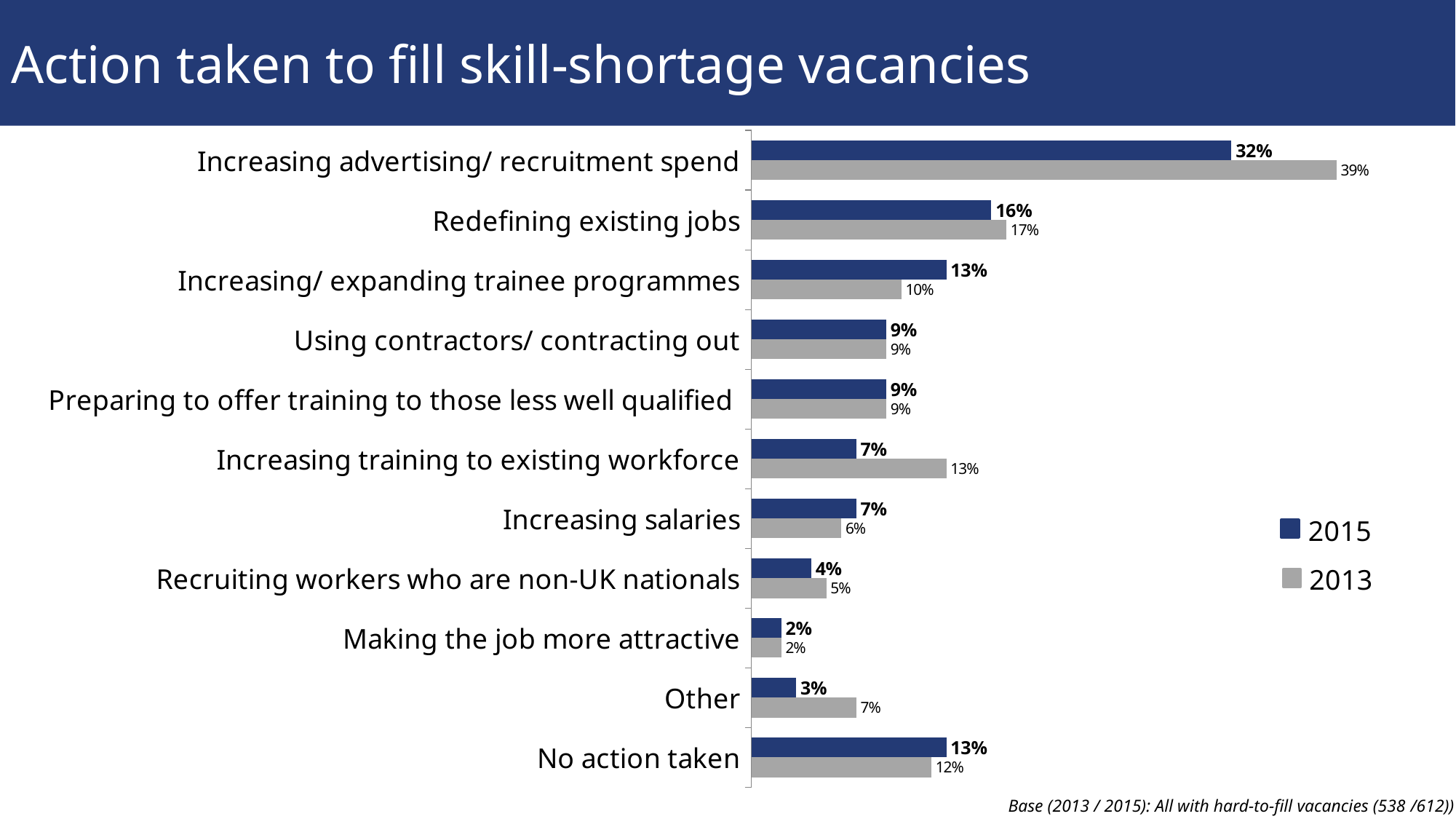
What is the difference between the 2013 and 2015 values for Increasing advertising/ recruitment spend? 7% How many series does the legend list? 2 What is the 2013 value for Increasing training to existing workforce? 13% What is the 2013 value for Other? 7% What is the difference between the 2015 and 2013 values for Increasing/ expanding trainee programmes? 3% Which is larger for No action taken, the 2015 value or the 2013 value? 2015 Which category has the highest 2013 value? Increasing advertising/ recruitment spend What is the 2015 value for Increasing advertising/ recruitment spend? 32% What kind of chart is shown on the slide? Bar chart How many categories are shown on the chart? 11 Which category has the lowest 2015 value? Making the job more attractive Which is larger for Increasing training to existing workforce, the 2015 value or the 2013 value? 2013